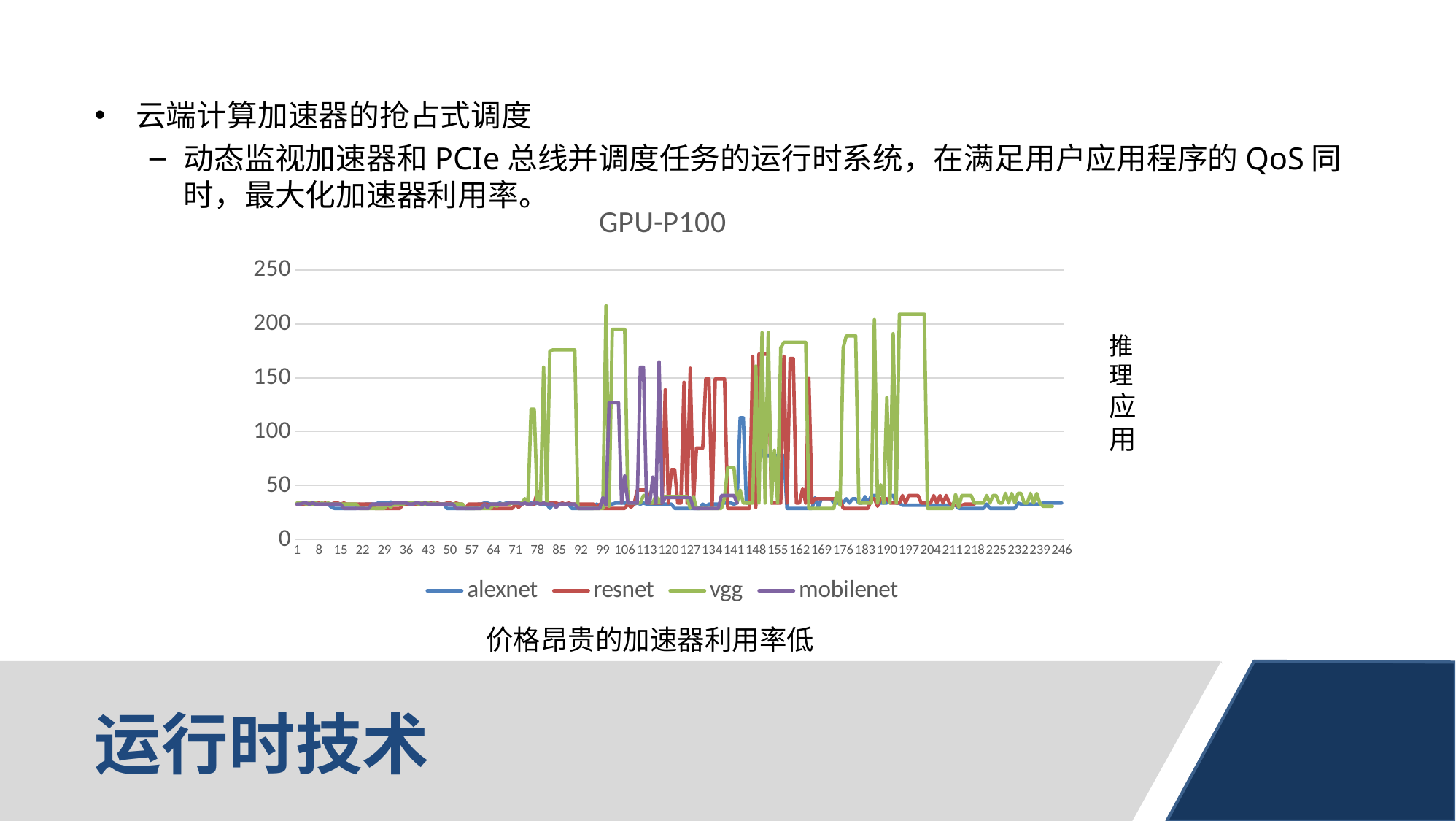
Is the highest value of the resnet series greater or less than 200? less Which series has the lowest peak value in the GPU-P100 chart? alexnet Is the highest value of the vgg series greater or less than 200? greater Does any series in the GPU-P100 chart exceed 250? No Which series reaches the highest peak value in the GPU-P100 chart? vgg What kind of chart is shown on the slide? line chart What is the title of the chart? GPU-P100 Which colour is used for the vgg series in the chart? green What is the last label shown on the x axis of the GPU-P100 chart? 246 How many series does the legend of the GPU-P100 chart list? 4